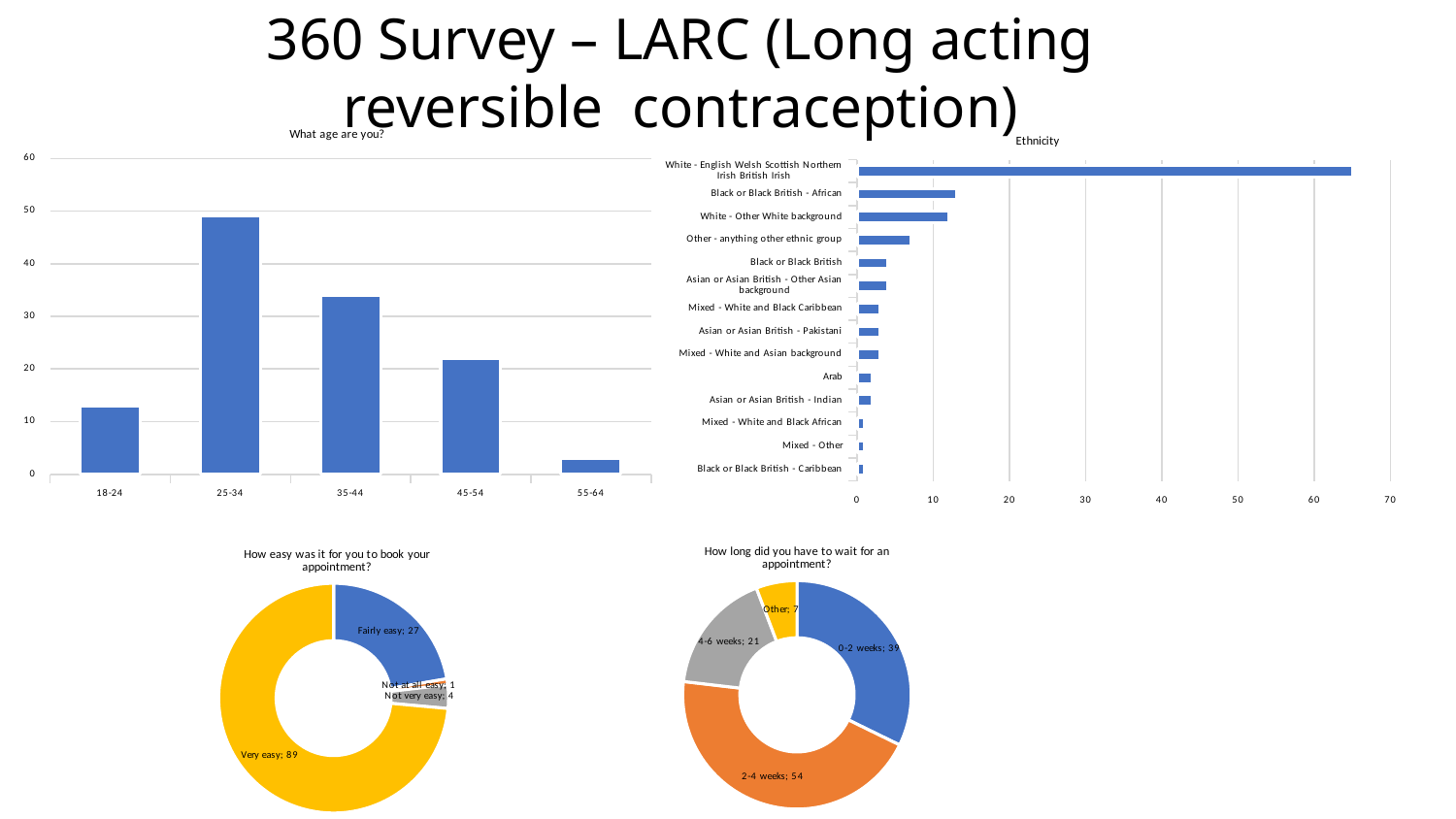
How many age groups are shown in the 'What age are you?' chart? 5 In the 'Ethnicity' chart, is the value for 'White - English Welsh Scottish Northern Irish British Irish' greater or less than 60? greater In the 'Ethnicity' chart, which is larger: 'Black or Black British - African' or 'Arab'? Black or Black British - African In the 'What age are you?' chart, which age group has the highest value? 25-34 In the 'How easy was it for you to book your appointment?' chart, what is the value for 'Very easy'? 89 In the 'Ethnicity' chart, which category has the highest value? White - English Welsh Scottish Northern Irish British Irish In the 'How easy was it for you to book your appointment?' chart, what is the difference between 'Very easy' and 'Fairly easy'? 62 In the 'What age are you?' chart, is the value for 25-34 greater or less than 40? greater What kind of chart is the 'Ethnicity' chart? bar chart In the 'What age are you?' chart, which age group has the lowest value? 55-64 In the 'What age are you?' chart, is the value for 55-64 greater or less than 10? less In the 'How long did you have to wait for an appointment?' chart, what is the value for '2-4 weeks'? 54